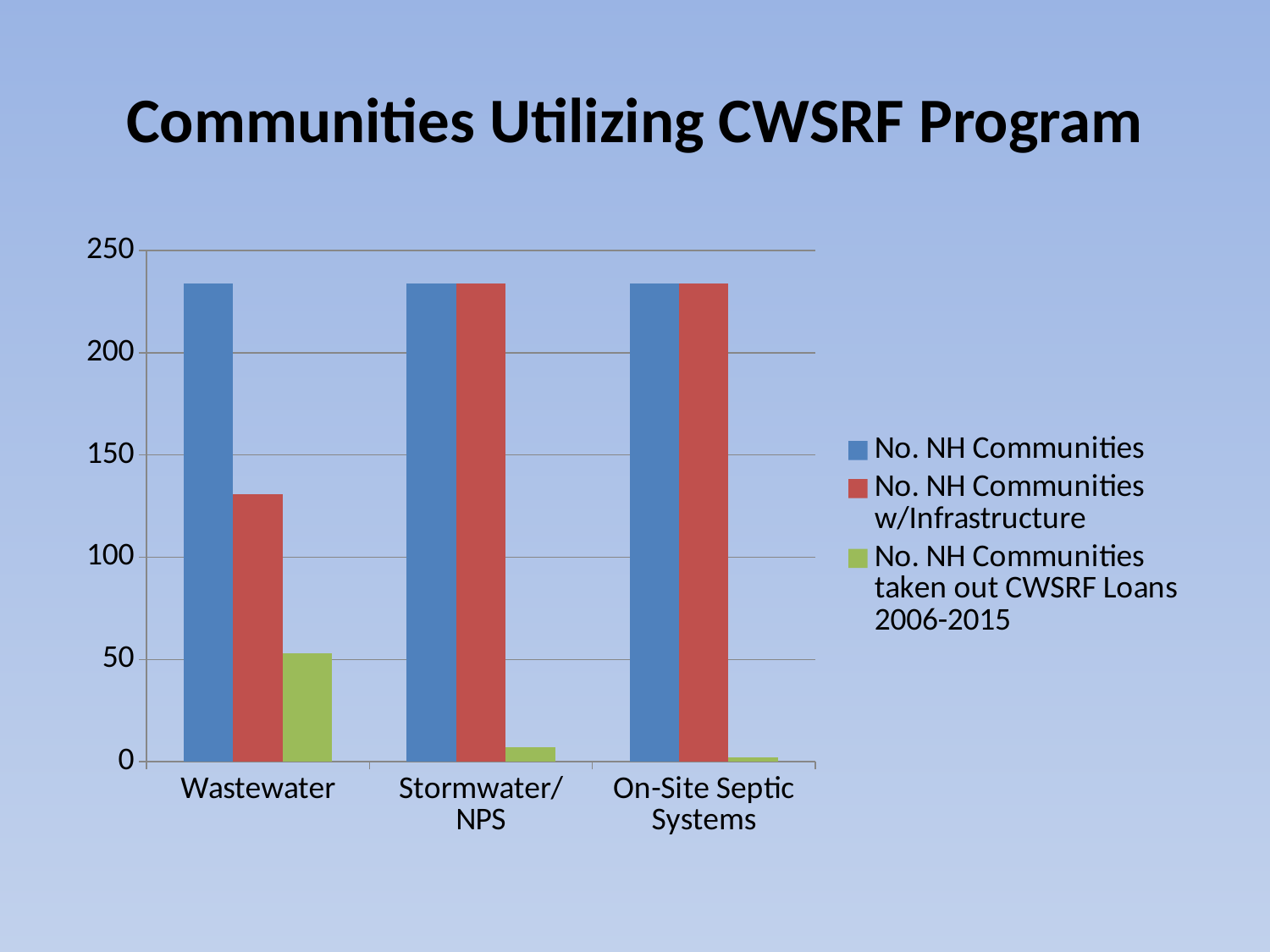
Is the value for No. NH Communities w/Infrastructure in the Wastewater category greater or less than 150? less What is the title of the chart? Communities Utilizing CWSRF Program Which category has the highest value for No. NH Communities taken out CWSRF Loans 2006-2015? Wastewater Which colour represents No. NH Communities taken out CWSRF Loans 2006-2015 in the legend? green How many series does the legend list? 3 What kind of chart is shown on the slide? bar chart For No. NH Communities w/Infrastructure, which is larger: Wastewater or Stormwater/NPS? Stormwater/NPS Is the value for No. NH Communities in the Stormwater/NPS category greater or less than 200? greater Is the value for No. NH Communities w/Infrastructure in the Wastewater category greater or less than 100? greater Which category has the lowest value for No. NH Communities w/Infrastructure? Wastewater How many categories are shown on the x axis? 3